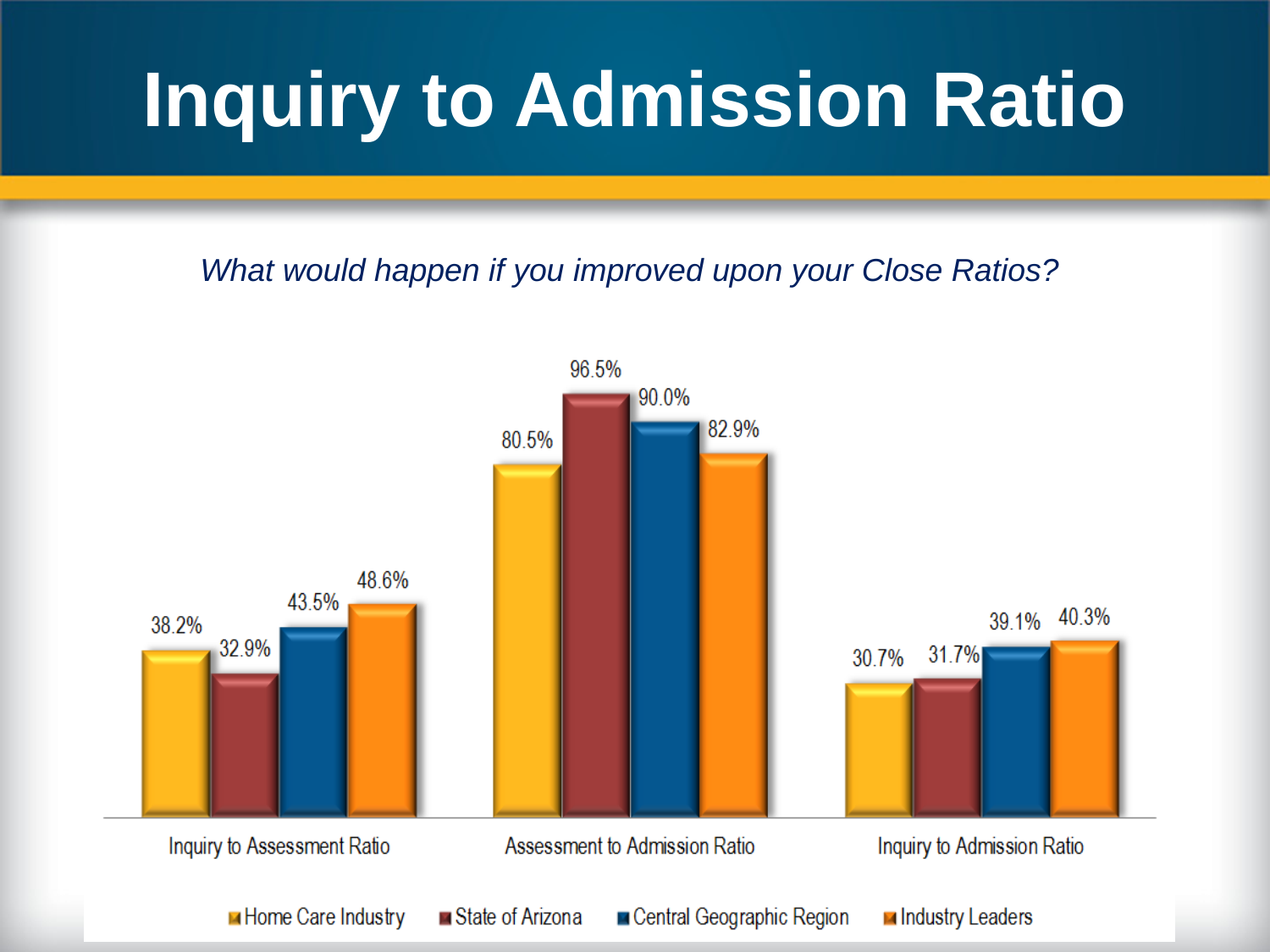
Which series has the highest Assessment to Admission Ratio? State of Arizona What is the difference between the State of Arizona and Central Geographic Region values for Assessment to Admission Ratio? 6.5% Which legend entry is shown in blue? Central Geographic Region Which series has the lowest Inquiry to Admission Ratio? Home Care Industry How many series does the legend list? 4 What kind of chart is shown on the slide? Bar chart How many categories are shown on the x axis? 3 What is the difference between the Industry Leaders and Home Care Industry values for Inquiry to Assessment Ratio? 10.4% What is the Inquiry to Assessment Ratio for the State of Arizona? 32.9% For Assessment to Admission Ratio, which is larger: Home Care Industry or Central Geographic Region? Central Geographic Region What is the Inquiry to Admission Ratio for the Central Geographic Region? 39.1% What is the Assessment to Admission Ratio for Industry Leaders? 82.9%